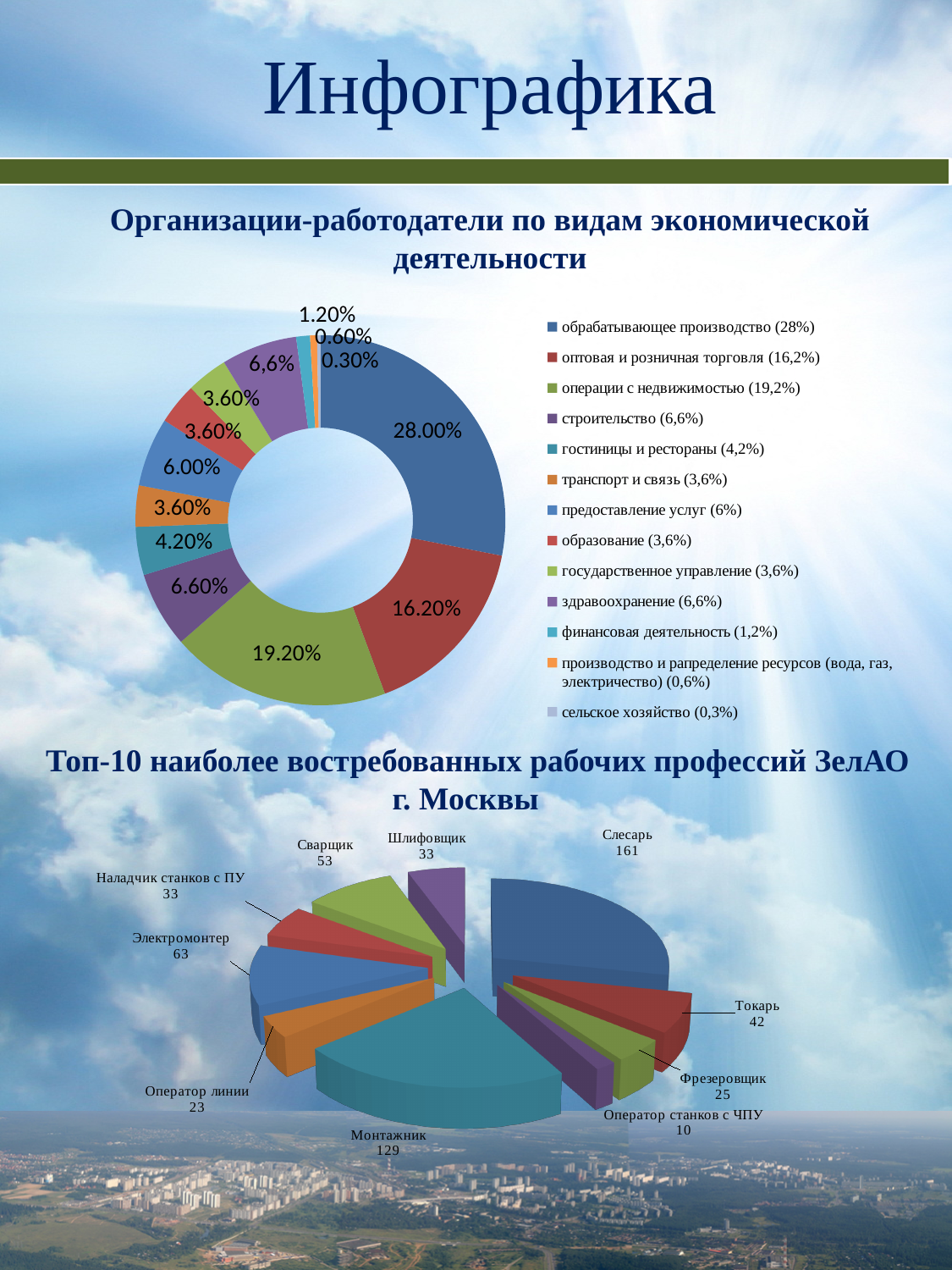
In the chart 'Топ-10 наиболее востребованных рабочих профессий ЗелАО г. Москвы', which is larger, Электромонтер or Сварщик? Электромонтер In the chart 'Топ-10 наиболее востребованных рабочих профессий ЗелАО г. Москвы', which profession has the lowest value? Оператор станков с ЧПУ In the chart 'Топ-10 наиболее востребованных рабочих профессий ЗелАО г. Москвы', what is the value for Монтажник? 129 In the chart 'Организации-работодатели по видам экономической деятельности', which category has the smallest share? сельское хозяйство In the chart 'Организации-работодатели по видам экономической деятельности', what share is shown for обрабатывающее производство? 28.00% What kind of chart is 'Организации-работодатели по видам экономической деятельности'? doughnut chart What kind of chart is 'Топ-10 наиболее востребованных рабочих профессий ЗелАО г. Москвы'? pie chart In the chart 'Организации-работодатели по видам экономической деятельности', how many categories does the legend list? 13 In the chart 'Топ-10 наиболее востребованных рабочих профессий ЗелАО г. Москвы', what is the difference between Слесарь and Монтажник? 32 In the chart 'Организации-работодатели по видам экономической деятельности', which category has the largest share? обрабатывающее производство In the chart 'Топ-10 наиболее востребованных рабочих профессий ЗелАО г. Москвы', what is the value for Слесарь? 161 In the chart 'Организации-работодатели по видам экономической деятельности', what share is shown for операции с недвижимостью? 19.20%